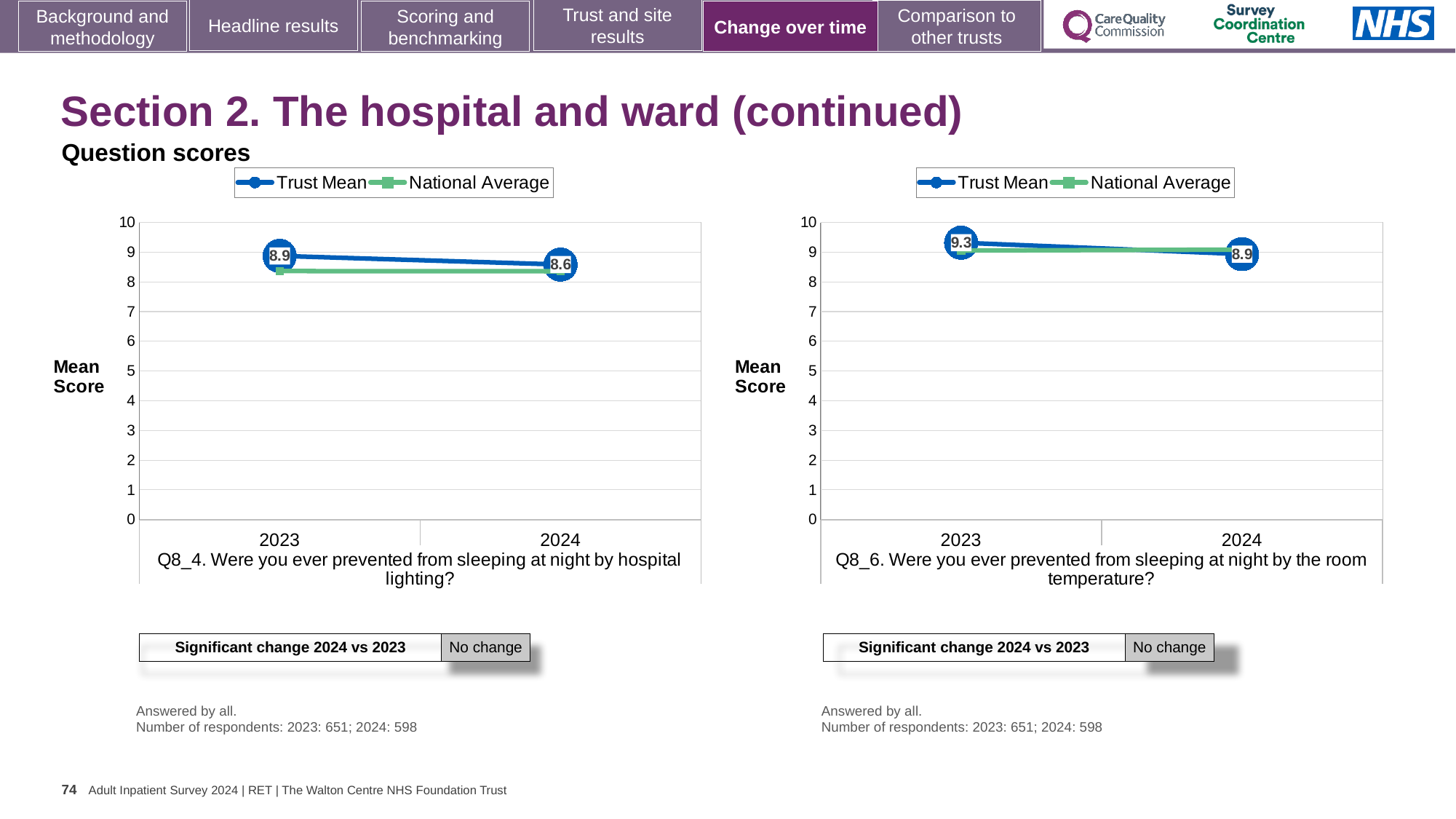
In the right chart (Q8_6, room temperature), what is the Trust Mean score for 2024? 8.9 In the left chart (Q8_4), by how much did the Trust Mean change from 2023 to 2024? 0.3 In the right chart (Q8_6), what is the difference between the Trust Mean in 2023 and 2024? 0.4 In the right chart (Q8_6), does the Trust Mean rise or fall from 2023 to 2024? fall What type of chart is used on this slide? line chart In the left chart (Q8_4, hospital lighting), what is the Trust Mean score for 2024? 8.6 How many years are plotted on the x axis of the right chart? 2 In the left chart (Q8_4), which is higher in 2023: the Trust Mean or the National Average? Trust Mean In the left chart (Q8_4, hospital lighting), what is the Trust Mean score for 2023? 8.9 In the right chart (Q8_6, room temperature), what is the Trust Mean score for 2023? 9.3 In the left chart (Q8_4), is the National Average for 2024 greater or less than 9? less How many series does the legend of the left chart list? 2